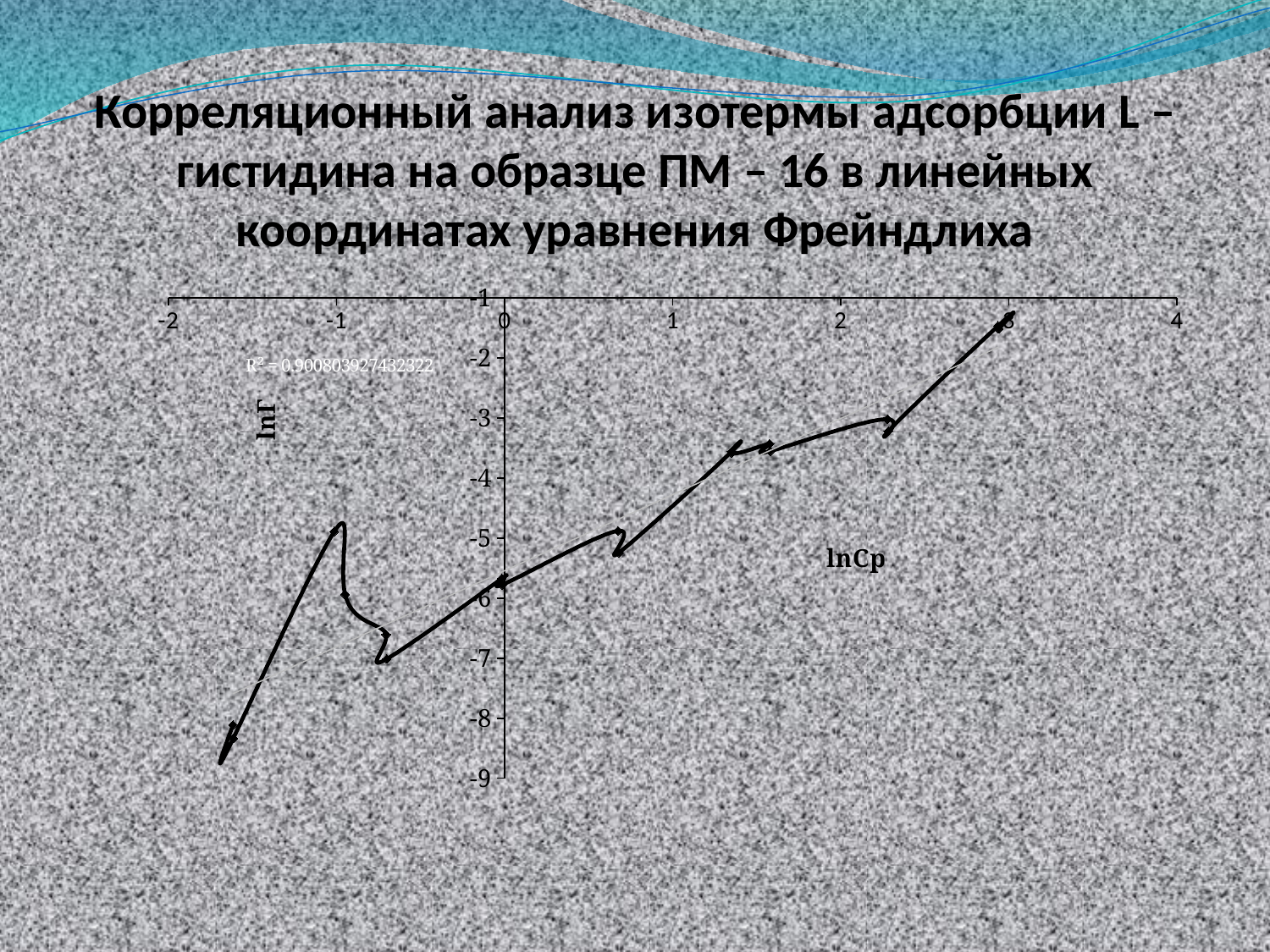
Is the lnГ value of the point at lnCp = 0 greater or less than -5? less Which point has the higher lnГ value: the one near lnCp = 3 or the one near lnCp = -1.6? the one near lnCp = 3 Is the lnГ value of the leftmost point (near lnCp = -1.6) greater or less than -8? less Do the lnГ values generally rise or fall as lnCp increases along the x axis? rise Is the lnГ value of the rightmost point (near lnCp = 3) greater or less than -2? greater What is the R² value printed on the chart? R² = 0.900803927432322 What kind of chart is shown on the slide? line chart What is the label of the vertical axis of the chart? lnГ Which point has the lowest lnГ value on the chart: the leftmost point near lnCp = -1.6 or the point near lnCp = -0.7? the leftmost point near lnCp = -1.6